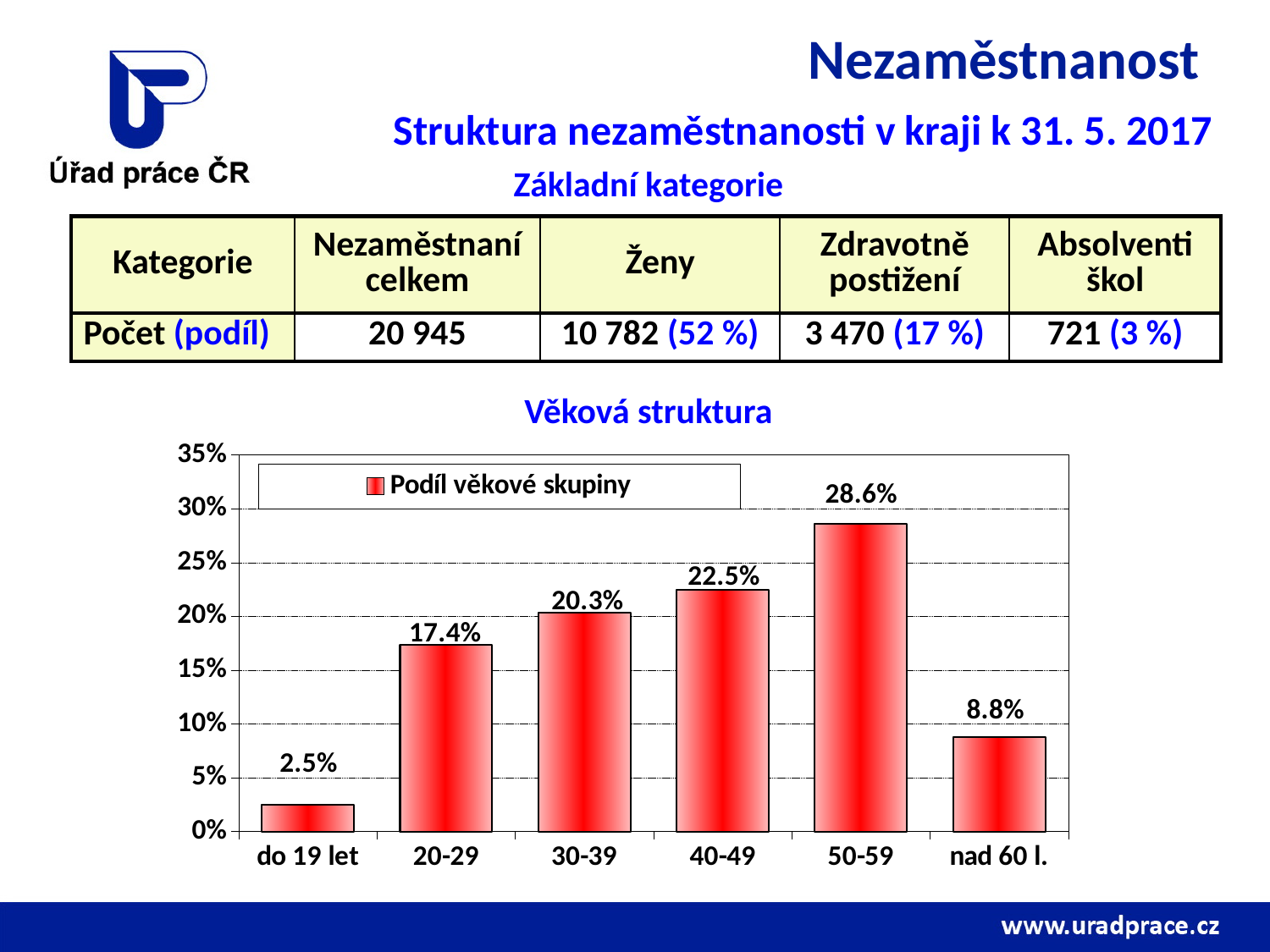
What is the value for the 20-29 age group in the Věková struktura chart? 17.4% Which age group has the highest share in the Věková struktura chart? 50-59 Which is larger in the Věková struktura chart, the value for 30-39 or for 40-49? 40-49 How many age groups are shown in the Věková struktura chart? 6 Is the value for 'nad 60 l.' in the Věková struktura chart greater or less than 10%? less What is the difference between the 50-59 and 40-49 values in the Věková struktura chart? 6.1% What is the value for the 'nad 60 l.' age group in the Věková struktura chart? 8.8% Which age group has the lowest share in the Věková struktura chart? do 19 let What kind of chart is the Věková struktura chart? bar chart What is the value for the 50-59 age group in the Věková struktura chart? 28.6% What is the legend entry in the Věková struktura chart? Podíl věkové skupiny How many series does the legend of the Věková struktura chart list? 1